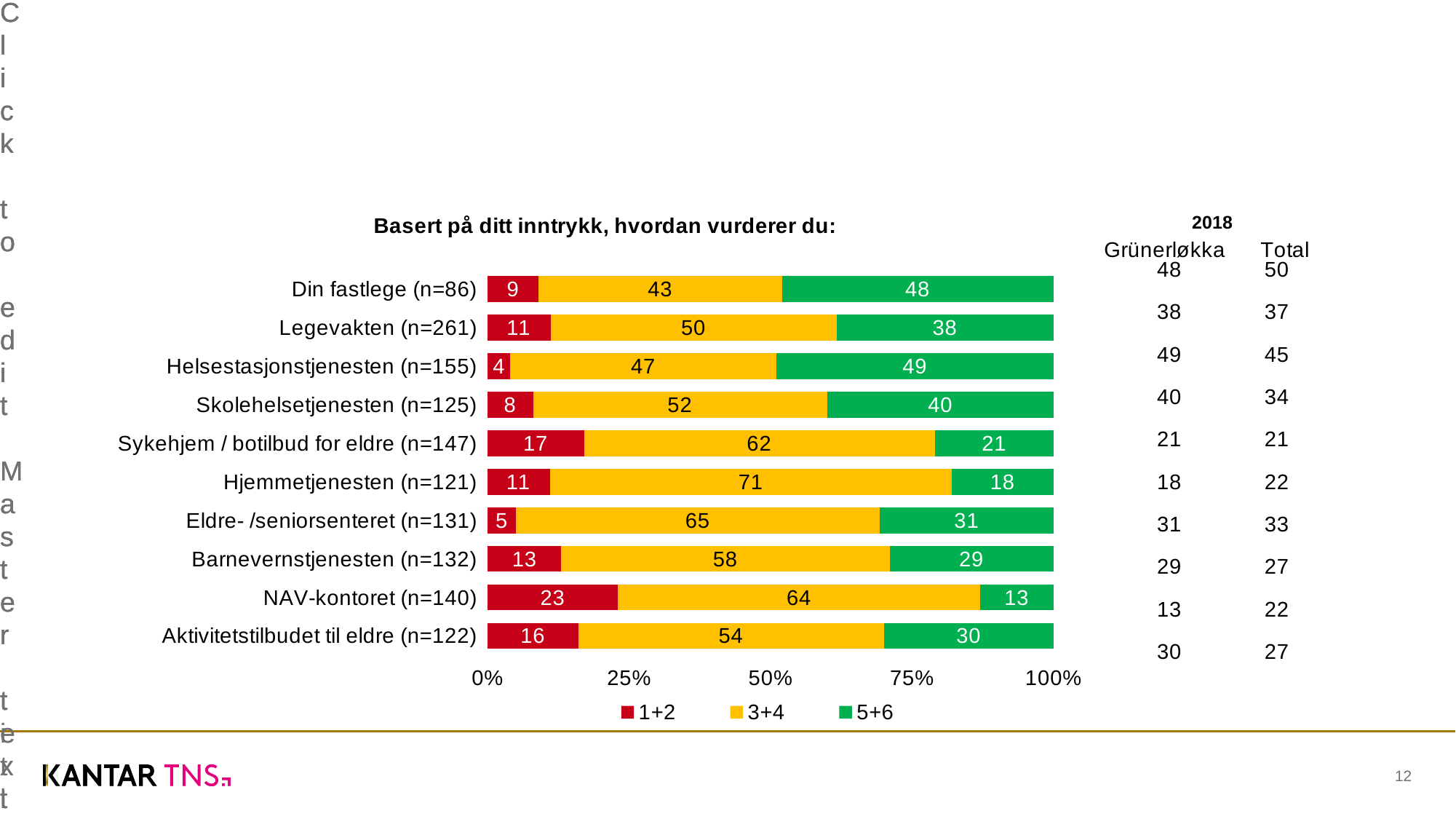
What is the total of the stacked bar for Sykehjem / botilbud for eldre (n=147)? 100 What is the difference between the 3+4 values for Hjemmetjenesten (n=121) and Din fastlege (n=86)? 28 What is the value of the 3+4 series for Hjemmetjenesten (n=121)? 71 Which category has the lowest value for the 1+2 series? Helsestasjonstjenesten (n=155) How many categories are plotted in the chart? 10 Which category has the lowest value for the 5+6 series? NAV-kontoret (n=140) What is the value of the 1+2 series for NAV-kontoret (n=140)? 23 Which is larger: the 5+6 value for Legevakten (n=261) or for Skolehelsetjenesten (n=125)? Skolehelsetjenesten (n=125) How many series does the legend list? 3 What type of chart is shown on the slide? Stacked bar chart Which category has the highest value for the 1+2 series? NAV-kontoret (n=140) What is the value of the 5+6 series for Din fastlege (n=86)? 48